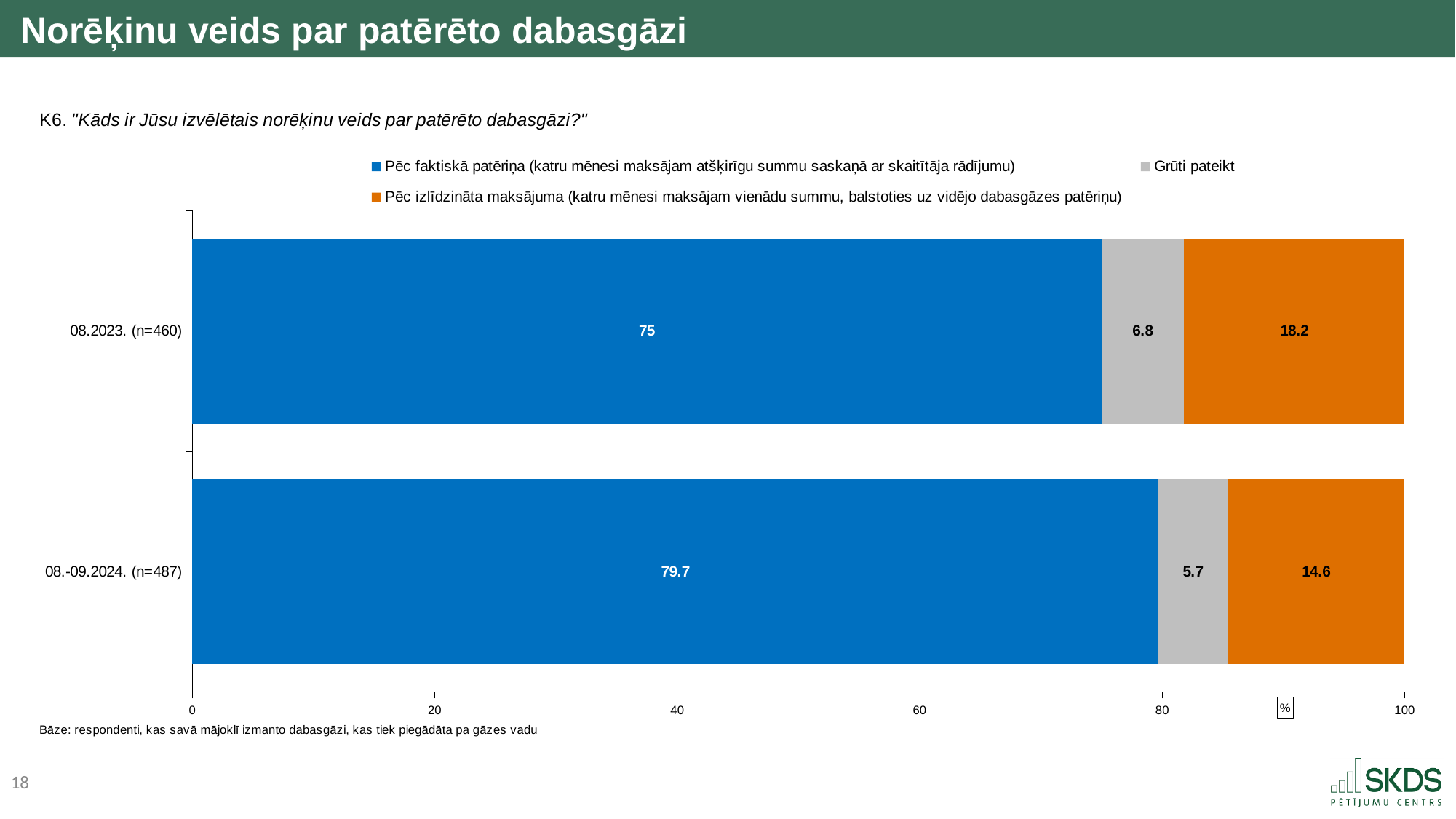
What kind of chart is shown on the slide? stacked bar chart What is the value for "Pēc faktiskā patēriņa" in 08.-09.2024. (n=487)? 79.7 What is the difference between the "Pēc faktiskā patēriņa" values for 08.-09.2024. (n=487) and 08.2023. (n=460)? 4.7 What is the total of the stacked bar for 08.-09.2024. (n=487)? 100 Is the value for "Pēc faktiskā patēriņa" in 08.2023. (n=460) greater or less than 80? less Which year has the larger value for "Pēc izlīdzināta maksājuma": 08.2023. (n=460) or 08.-09.2024. (n=487)? 08.2023. (n=460) What is the value for "Pēc izlīdzināta maksājuma" in 08.-09.2024. (n=487)? 14.6 How many categories (survey waves) are shown on the chart? 2 What is the value for "Grūti pateikt" in 08.2023. (n=460)? 6.8 What is the value for "Pēc izlīdzināta maksājuma" in 08.2023. (n=460)? 18.2 What is the value for "Pēc faktiskā patēriņa" in 08.2023. (n=460)? 75 How many series does the legend list? 3